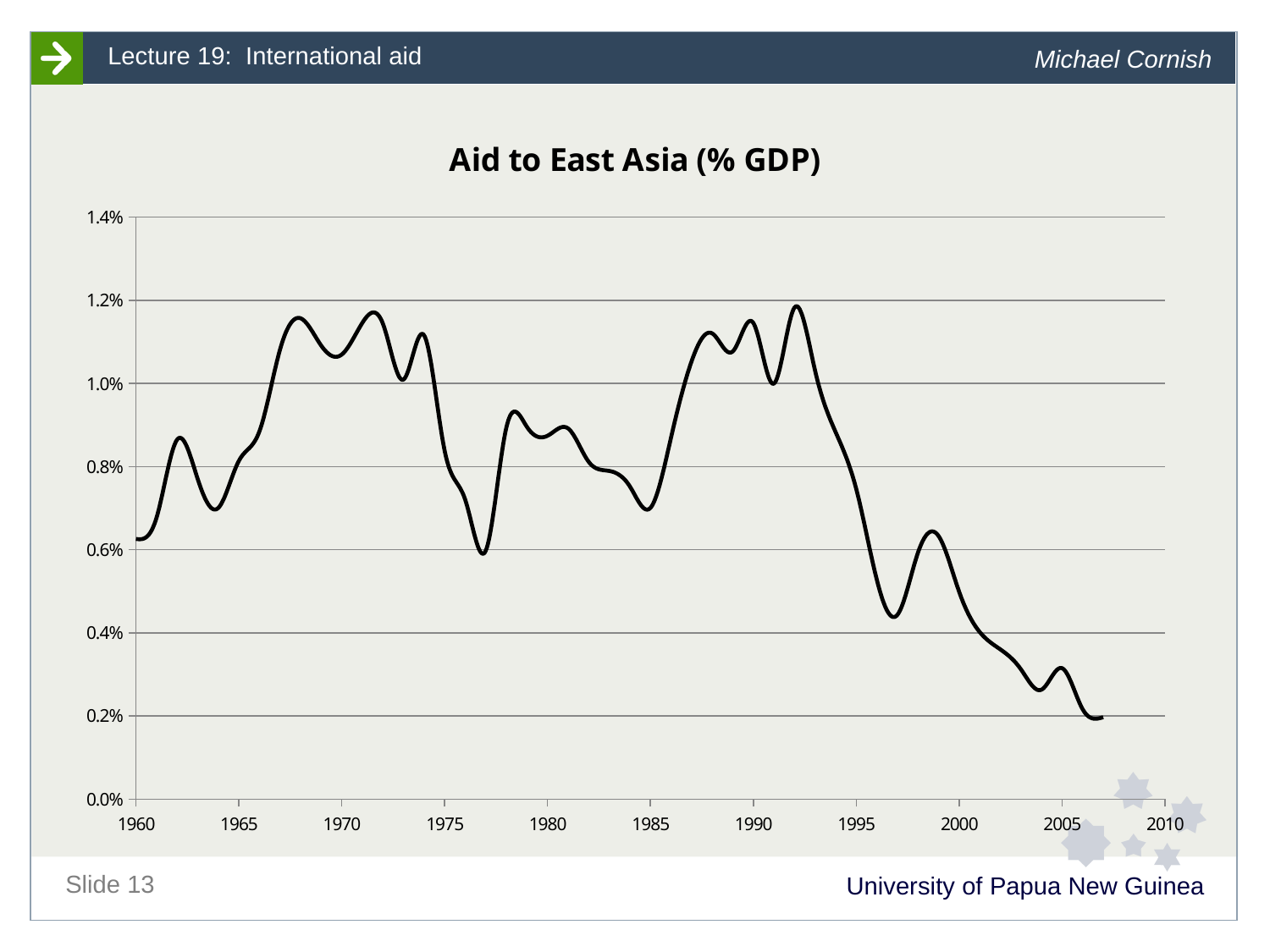
What kind of chart is shown on the slide? line chart Is the value for 1985 greater or less than 0.8%? less Which year has the larger value, 1960 or 1968? 1968 What is the highest value shown on the vertical axis? 1.4% What is the title of the chart? Aid to East Asia (% GDP) Overall, does aid to East Asia as a share of GDP rise or fall between 1960 and 2010? fall Is the value for 1980 greater or less than 1.0%? less Which year has the larger value, 1992 or 2005? 1992 Is the value for 2004 greater or less than 0.4%? less